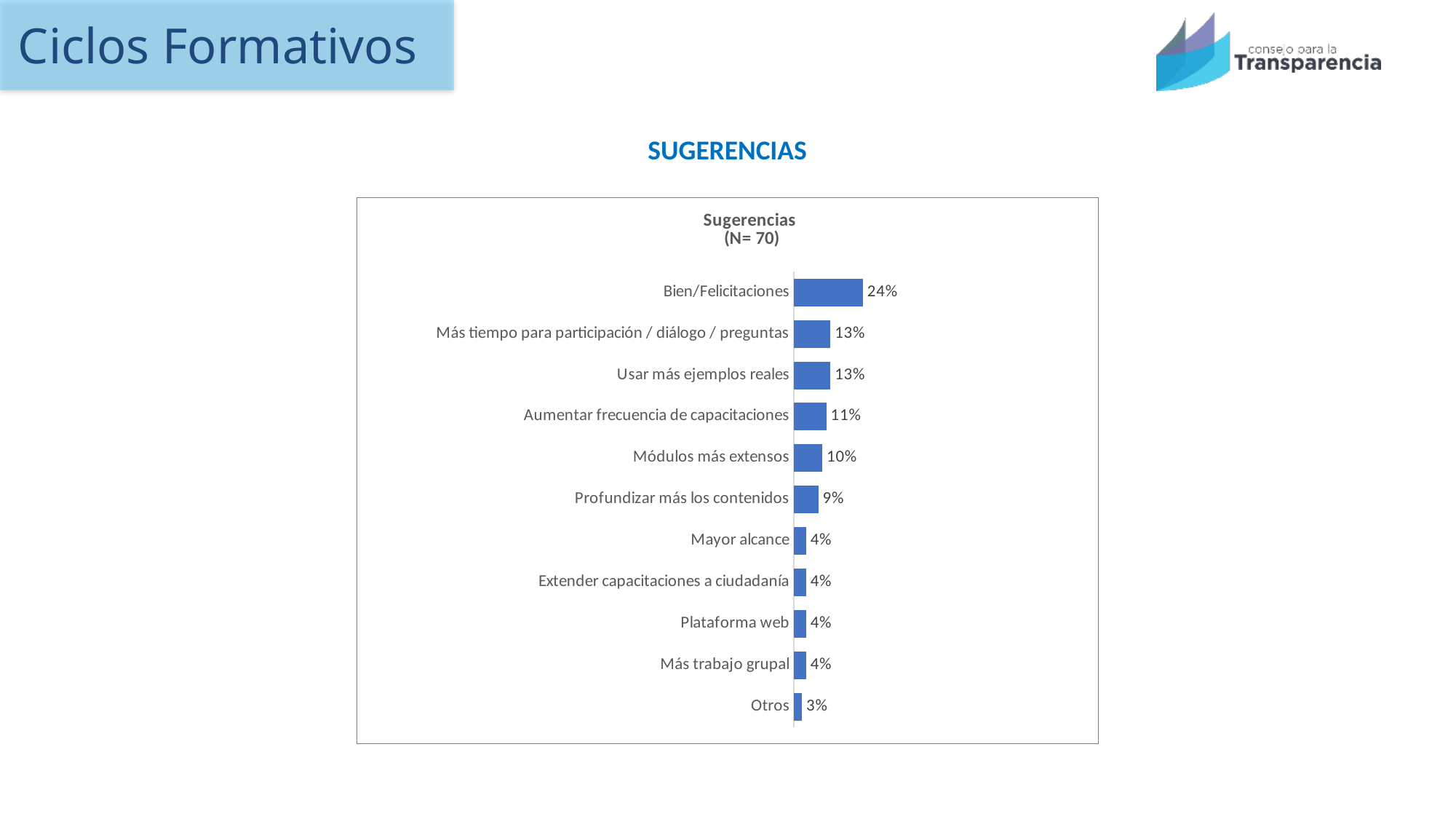
What is the difference between Bien/Felicitaciones and Usar más ejemplos reales? 11% What is the value for Bien/Felicitaciones? 24% What is the value for Otros? 3% Which is larger, Aumentar frecuencia de capacitaciones or Plataforma web? Aumentar frecuencia de capacitaciones What is the N value shown in the chart title? 70 What is the difference between Módulos más extensos and Mayor alcance? 6% Which category has the lowest value? Otros What kind of chart is shown? Bar chart What is the value for Aumentar frecuencia de capacitaciones? 11% How many categories are shown in the chart? 11 What is the value for Profundizar más los contenidos? 9% Which category has the highest value? Bien/Felicitaciones